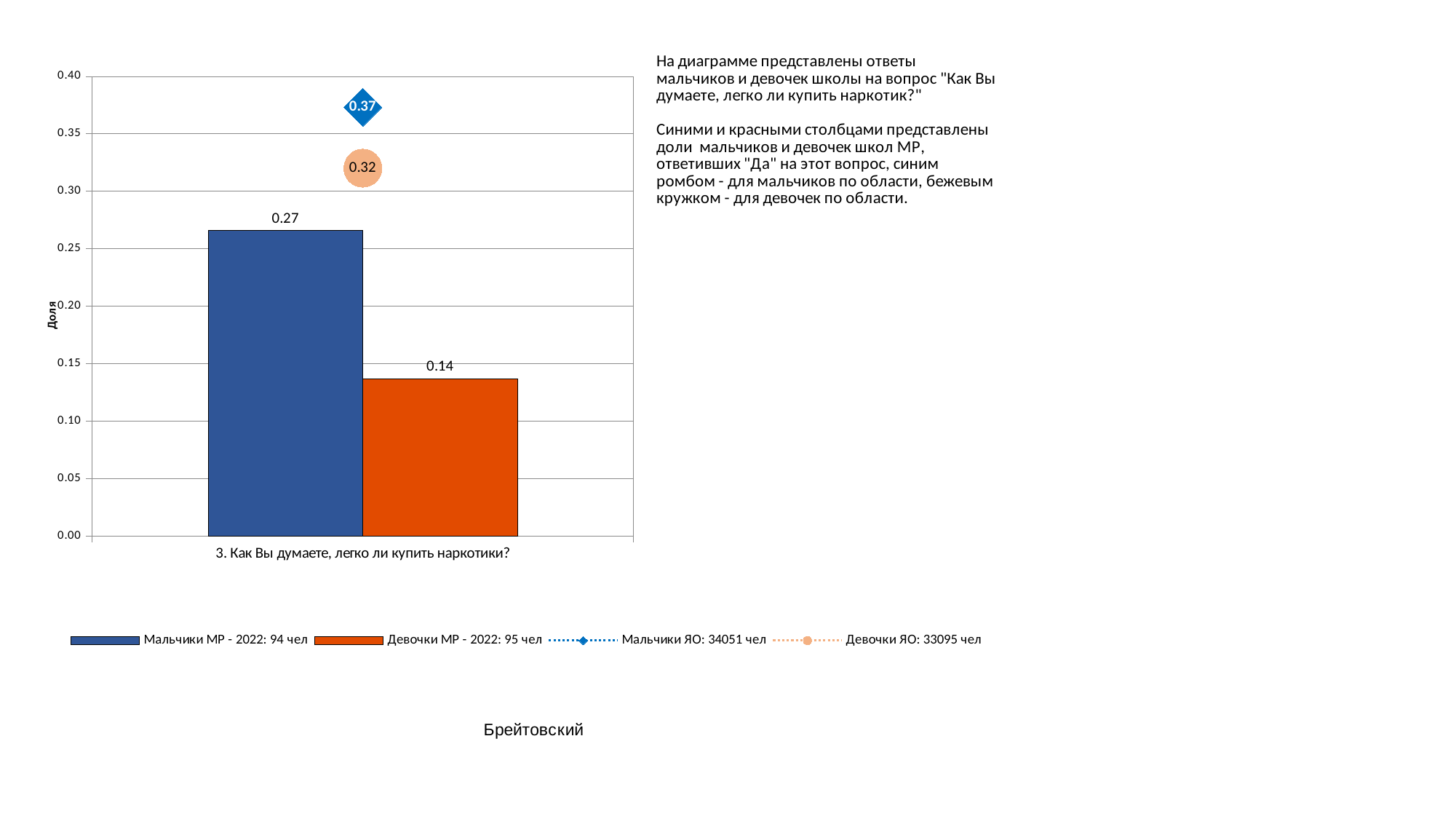
What is the value for Мальчики ЯО: 34051 чел? 0.37 Is the value for Мальчики МР - 2022: 94 чел greater or less than 0.30? less What is the value for Девочки ЯО: 33095 чел? 0.32 What is the label of the y axis? Доля What is the value for Мальчики МР - 2022: 94 чел? 0.27 Which is larger: the value for Мальчики ЯО: 34051 чел or Девочки ЯО: 33095 чел? Мальчики ЯО: 34051 чел How many series does the legend list? 4 What is the value for Девочки МР - 2022: 95 чел? 0.14 Which series has the lowest value? Девочки МР - 2022: 95 чел Which series has the highest value? Мальчики ЯО: 34051 чел What is the difference between the values for Мальчики МР - 2022: 94 чел and Девочки МР - 2022: 95 чел? 0.13 What kind of chart is shown on the slide? bar chart